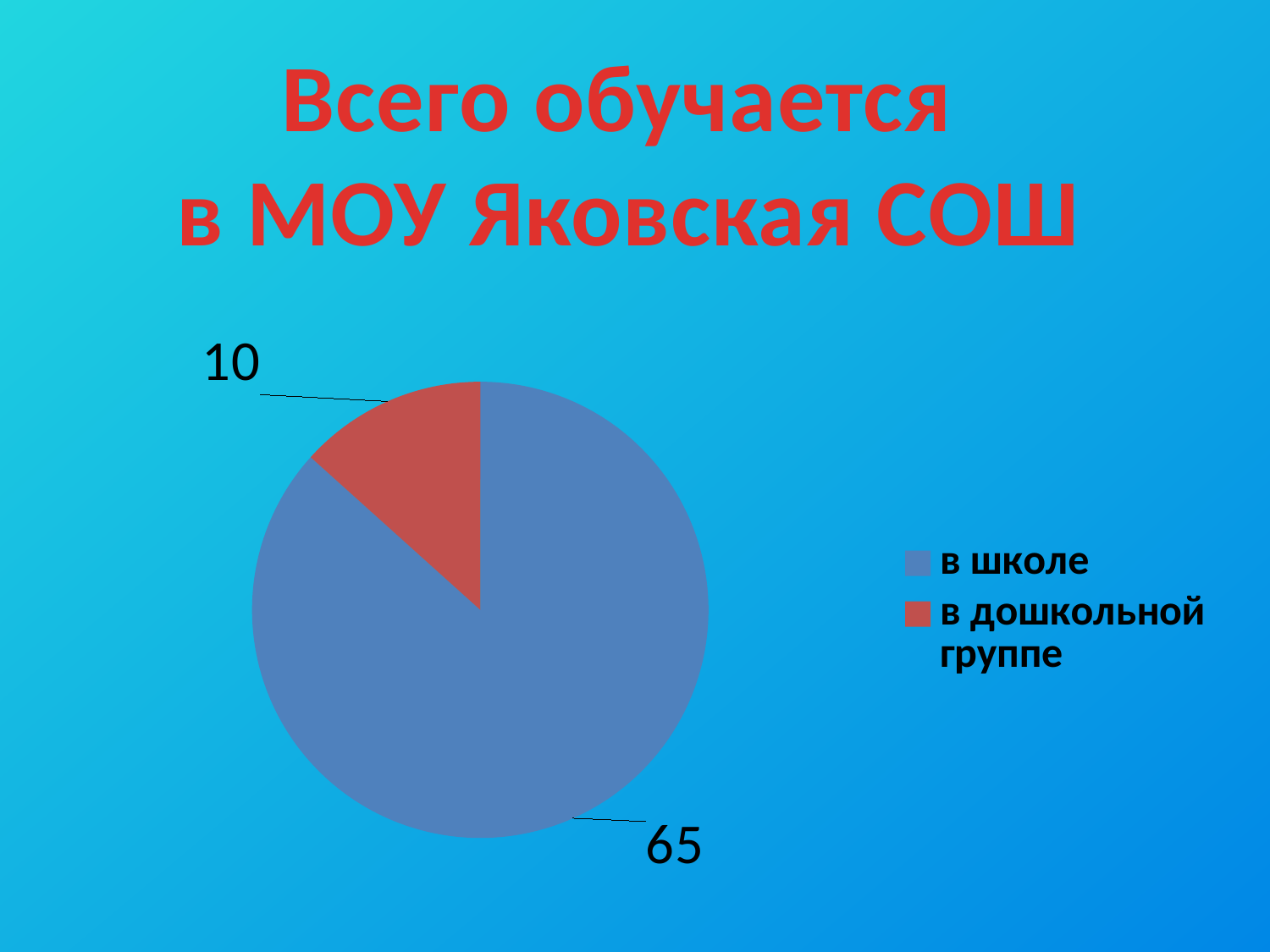
Which slice of the pie chart is the smallest? в дошкольной группе What is the value for the slice 'в дошкольной группе'? 10 What colour is the slice for 'в дошкольной группе'? red What is the title of the slide containing the pie chart? Всего обучается в МОУ Яковская СОШ What is the difference between the values for 'в школе' and 'в дошкольной группе'? 55 What type of chart is shown on the slide? pie chart Which is larger: the value for 'в школе' or the value for 'в дошкольной группе'? в школе What is the value for the slice 'в школе'? 65 How many slices does the pie chart have? 2 What is the total of all slices in the pie chart? 75 How many entries does the legend list? 2 Which slice of the pie chart is the largest? в школе